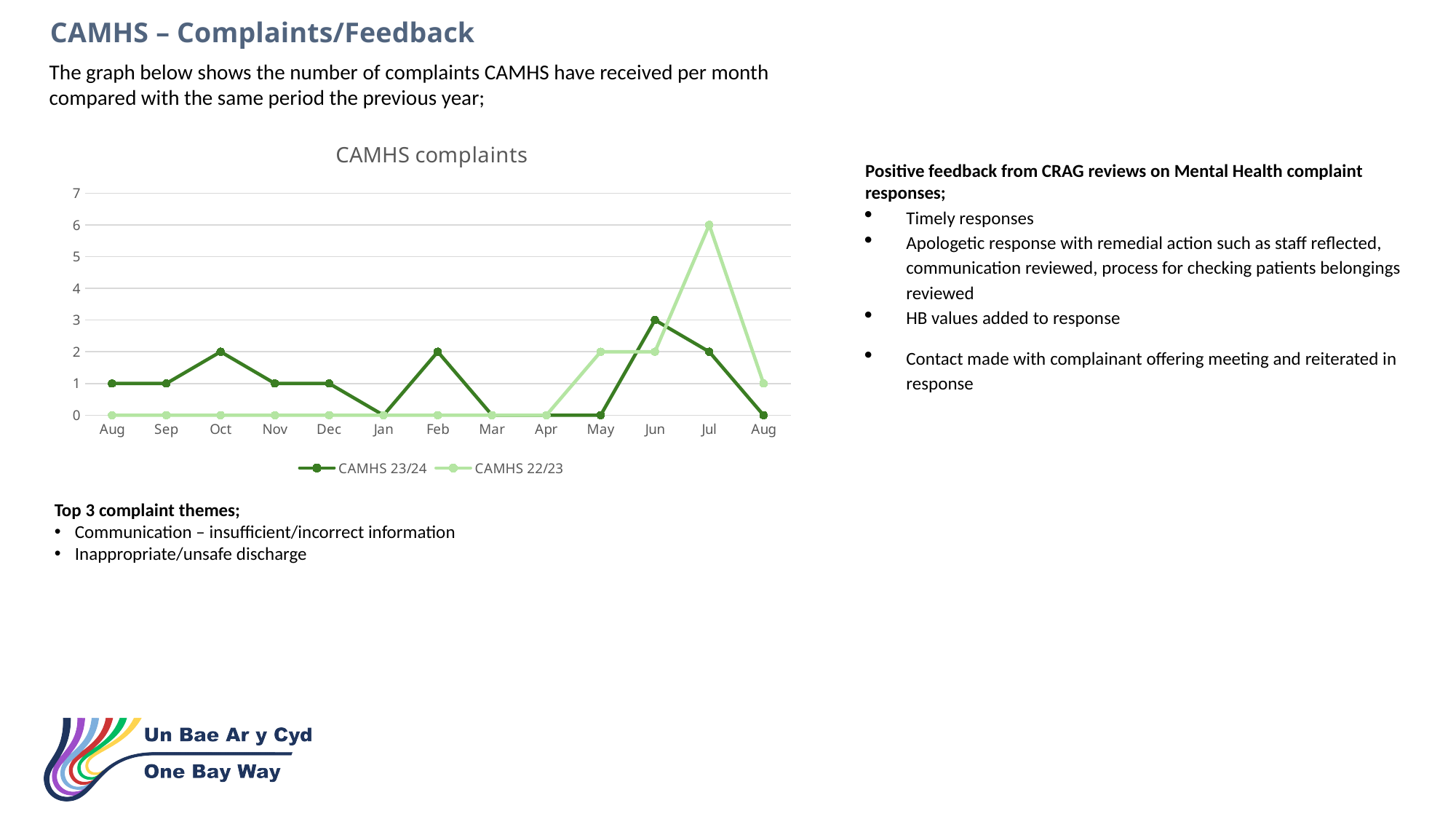
In which month does CAMHS 23/24 reach its highest value? Jun What is the value for CAMHS 22/23 in Jul? 6 What is the difference between CAMHS 22/23 and CAMHS 23/24 in Jul? 4 How many series does the chart legend list? 2 What is the title of the chart? CAMHS complaints What is the value for CAMHS 23/24 in Oct? 2 What is the value for CAMHS 23/24 in Jun? 3 Which series has the larger value in Jun, CAMHS 23/24 or CAMHS 22/23? CAMHS 23/24 How many months are shown on the x axis of the chart? 13 In which month does CAMHS 22/23 reach its highest value? Jul What type of chart is shown on the slide? Line chart Does the CAMHS 22/23 line rise or fall from Jul to Aug? Fall